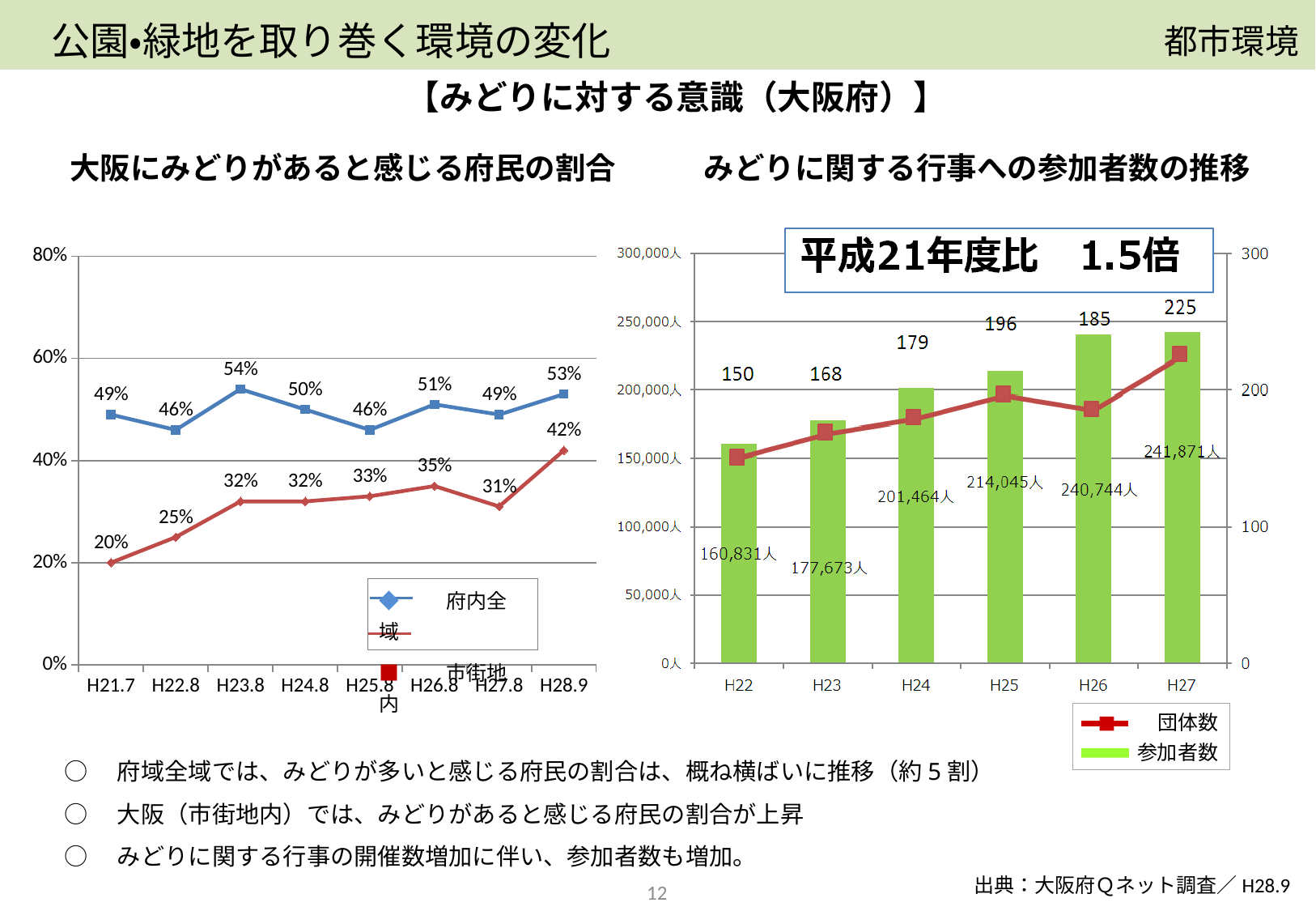
In the left chart (大阪にみどりがあると感じる府民の割合), what is the value for 府内全域 at H23.8? 54% In the left chart (大阪にみどりがあると感じる府民の割合), what kind of chart is it? Line chart In the right chart (みどりに関する行事への参加者数の推移), how many series does the legend list? 2 In the right chart (みどりに関する行事への参加者数の推移), what is the 団体数 value for H27? 225 In the right chart (みどりに関する行事への参加者数の推移), which year has the highest 団体数? H27 In the right chart (みどりに関する行事への参加者数の推移), which is larger, the 団体数 for H25 or for H26? H25 In the right chart (みどりに関する行事への参加者数の推移), what is the 参加者数 value for H25? 214,045人 In the left chart (大阪にみどりがあると感じる府民の割合), what is the value for 市街地内 at H28.9? 42% In the left chart (大阪にみどりがあると感じる府民の割合), what is the difference between the 府内全域 and 市街地内 values at H21.7? 29% In the right chart (みどりに関する行事への参加者数の推移), what is the difference in 参加者数 between H27 and H22? 81,040人 In the left chart (大阪にみどりがあると感じる府民の割合), at which x-axis point is the 市街地内 value lowest? H21.7 In the left chart (大阪にみどりがあると感じる府民の割合), how many x-axis points are plotted? 8